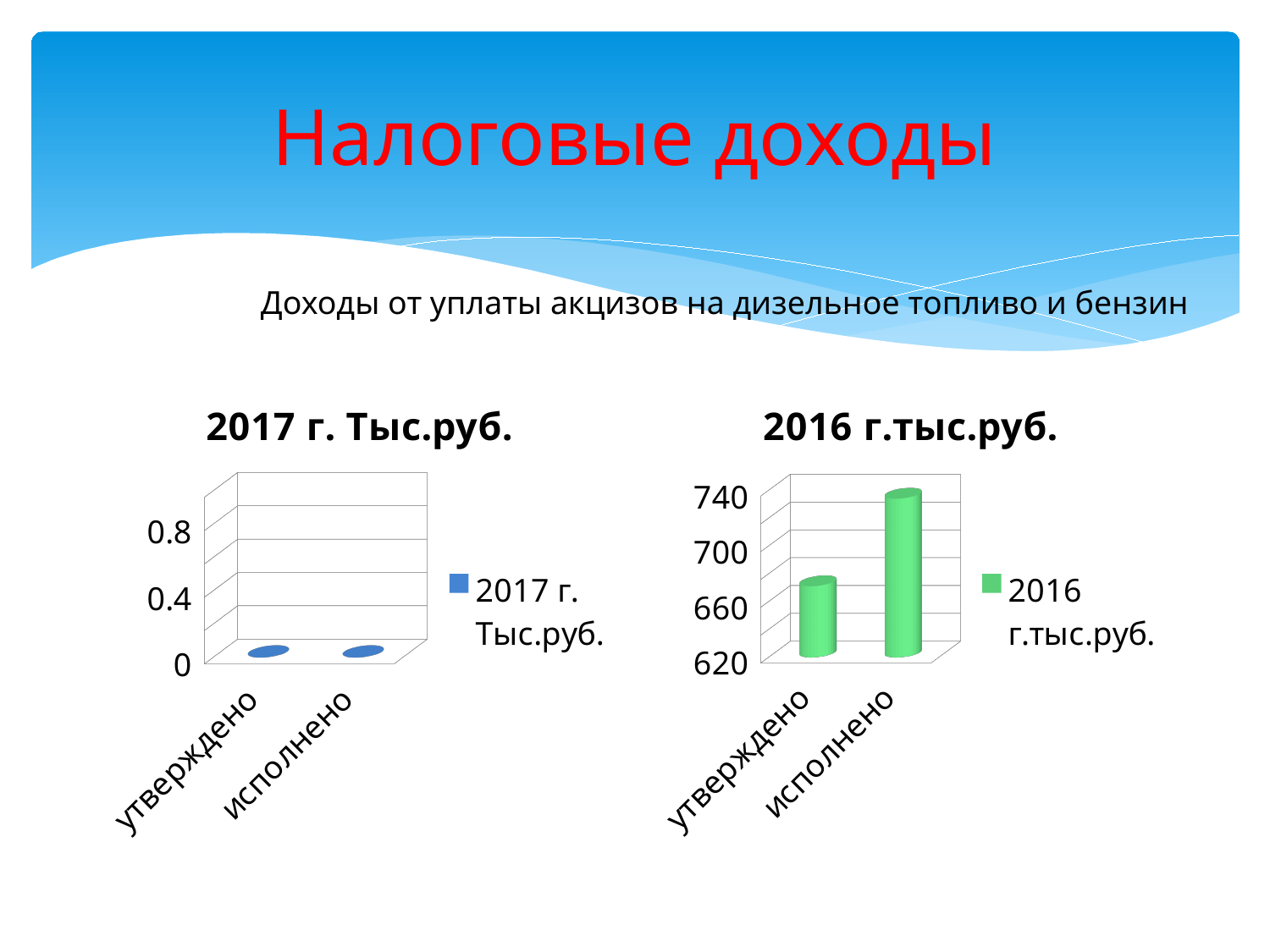
What kind of chart is the chart titled "2017 г. Тыс.руб."? bar chart How many categories are shown in the chart titled "2017 г. Тыс.руб."? 2 What kind of chart is the chart titled "2016 г.тыс.руб."? bar chart In the chart titled "2016 г.тыс.руб.", is the value for исполнено greater or less than 700? greater In the chart titled "2016 г.тыс.руб.", which is larger: утверждено or исполнено? исполнено How many categories are shown in the chart titled "2016 г.тыс.руб."? 2 In the chart titled "2016 г.тыс.руб.", which category has the highest value? исполнено In the chart titled "2016 г.тыс.руб.", which category has the lowest value? утверждено In the chart titled "2016 г.тыс.руб.", is the value for утверждено greater or less than 700? less In the chart titled "2017 г. Тыс.руб.", what is the value for утверждено? 0 What is the legend entry of the chart on the left of the slide? 2017 г. Тыс.руб. How many series does the legend of the chart titled "2016 г.тыс.руб." list? 1